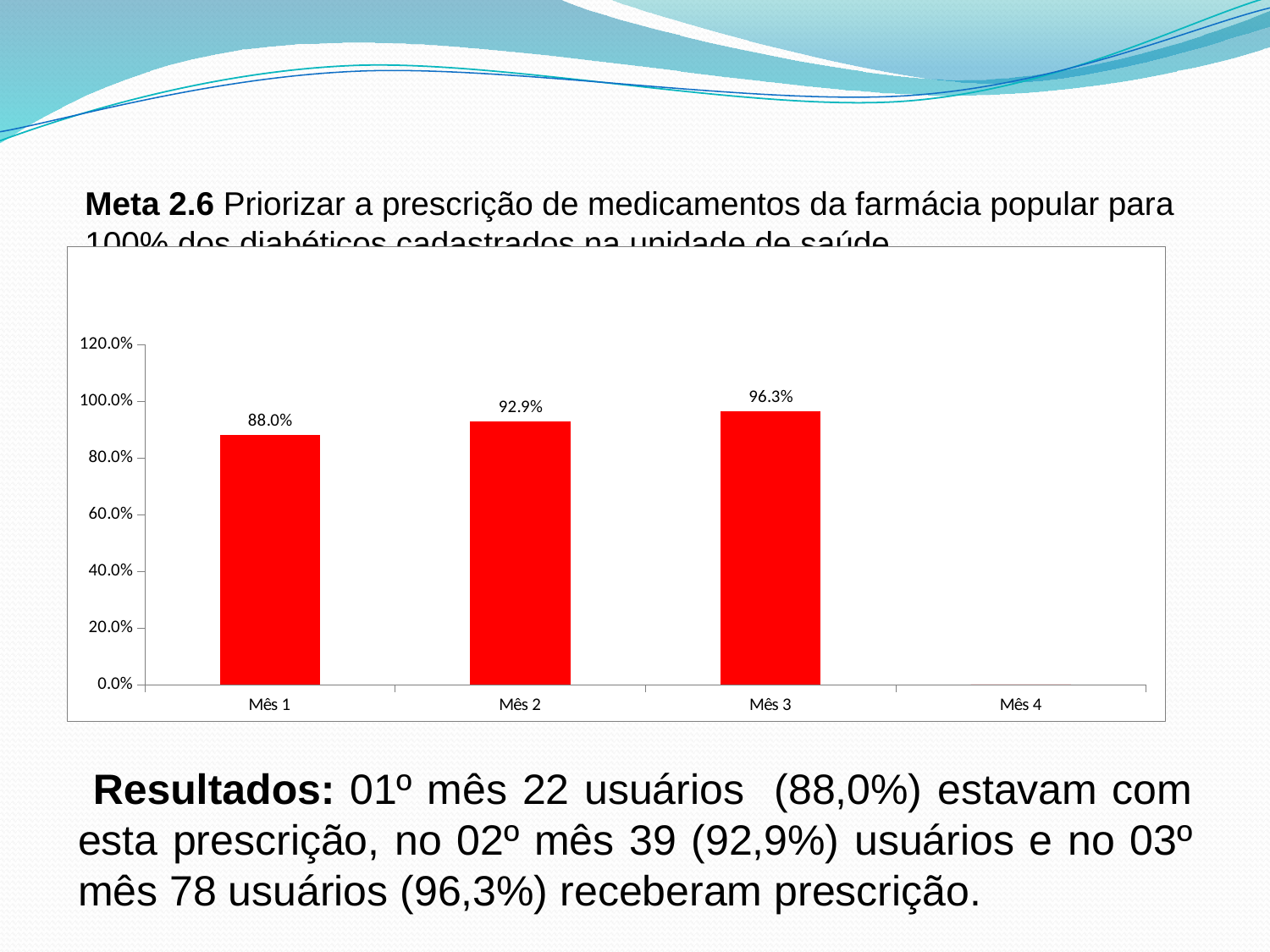
What kind of chart is shown on the slide? bar chart Which month has the highest value among the bars shown? Mês 3 Which is larger, the value for Mês 2 or the value for Mês 3? Mês 3 What is the value for Mês 2? 92.9% What is the difference between the values for Mês 2 and Mês 1? 4.9 percentage points Is the value for Mês 1 greater or less than 100.0%? less What is the value for Mês 1? 88.0% Do the values rise or fall from Mês 1 to Mês 3? rise Which of the months with a labelled bar has the lowest value? Mês 1 What is the value for Mês 3? 96.3% How many categories are shown on the x axis? 4 What is the difference between the values for Mês 3 and Mês 1? 8.3 percentage points